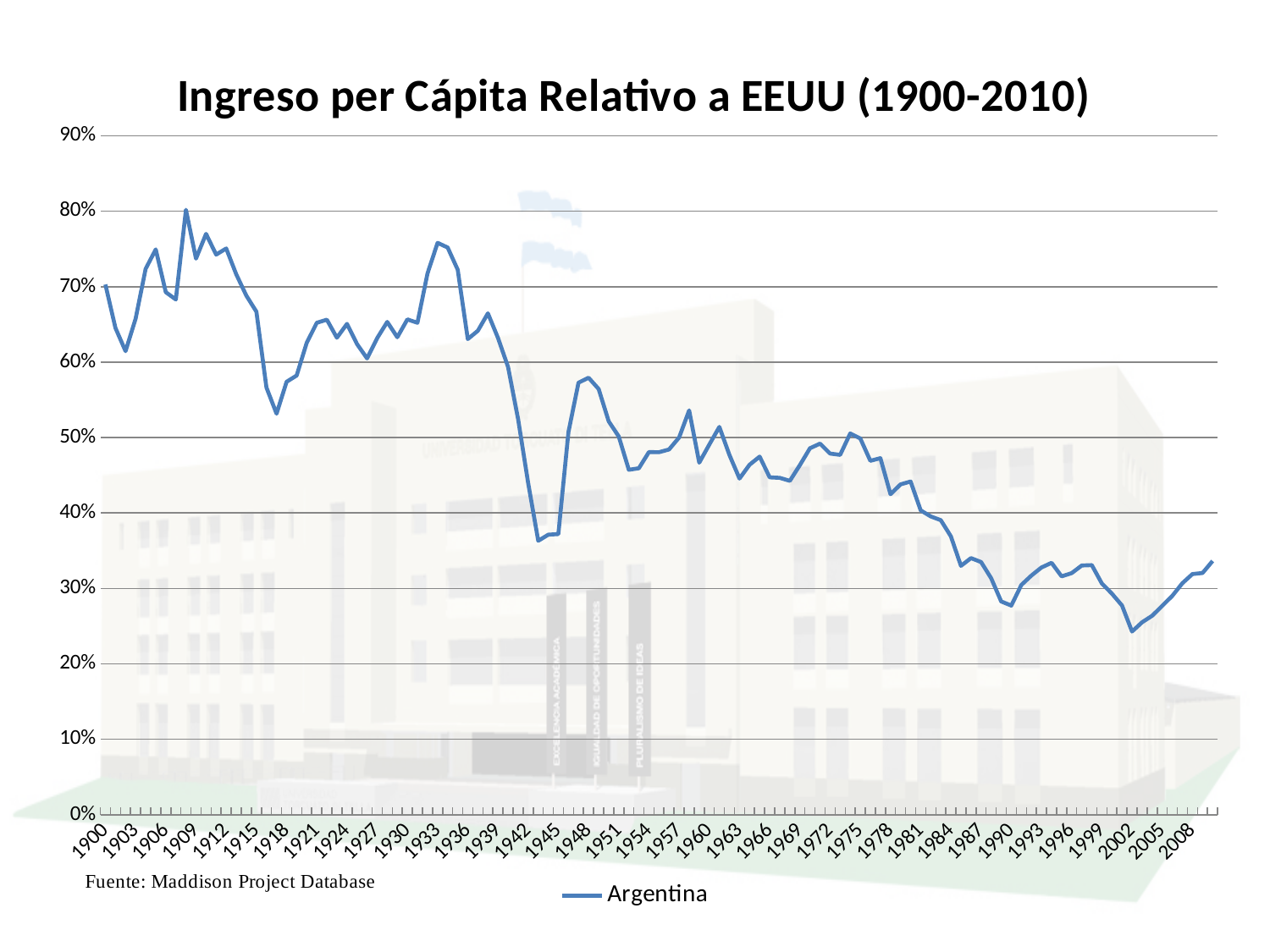
What series name appears in the legend? Argentina Is the value for Argentina in 2002 greater or less than 30%? less Overall, does the value for Argentina rise or fall from 1900 to 2010? fall Is the value for Argentina in 1909 greater or less than 70%? greater What is the title of the chart? Ingreso per Cápita Relativo a EEUU (1900-2010) Which year has the larger value for Argentina, 1909 or 2008? 1909 Is the value for Argentina in 1933 greater or less than 70%? greater How many series does the legend list? 1 Which year has the larger value for Argentina, 1900 or 2002? 1900 What kind of chart is shown on the slide? line chart